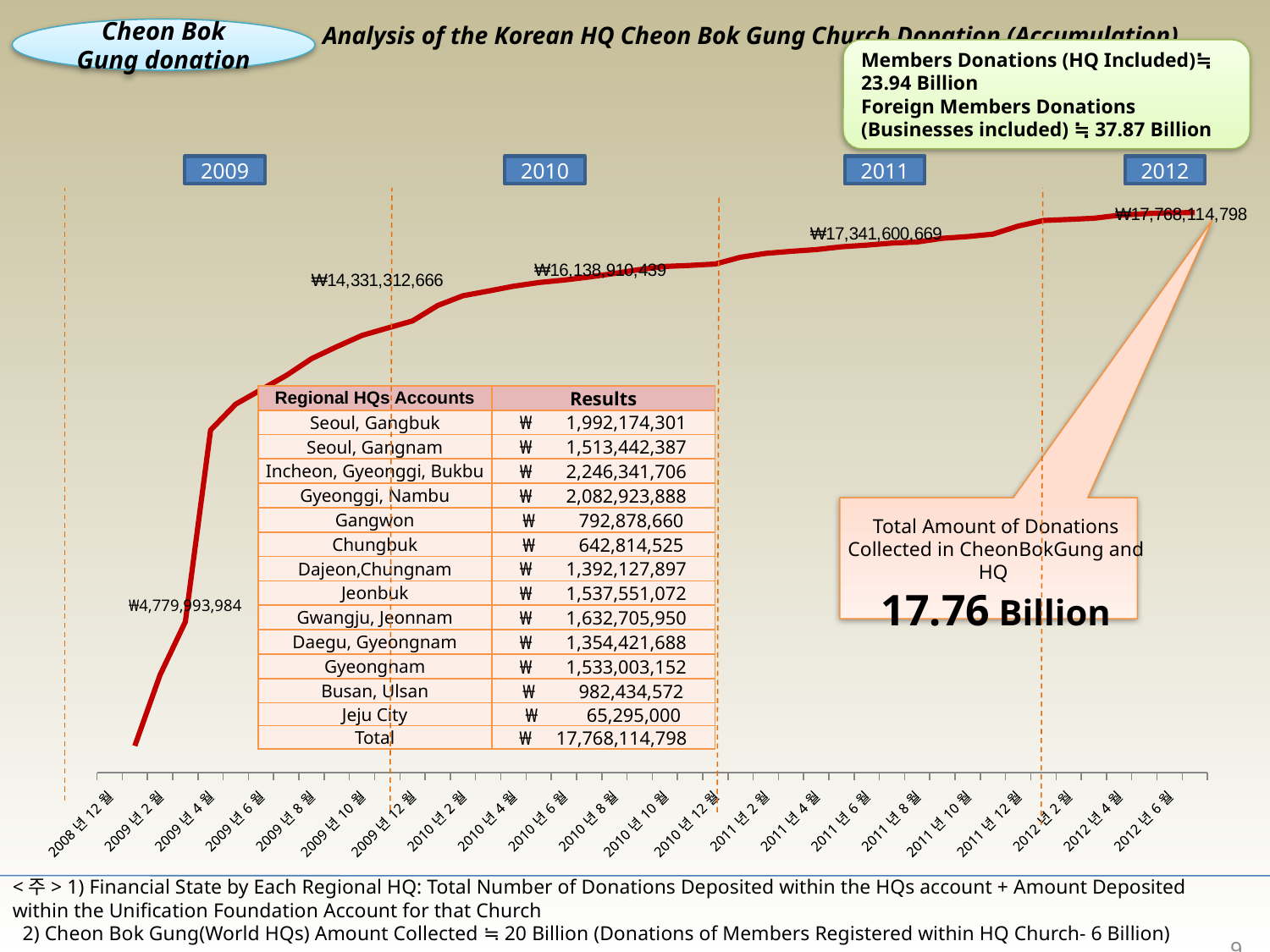
What is the difference between the third data label (₩16,138,910,439) and the second data label (₩14,331,312,666)? ₩1,807,597,773 What is the difference between the last data label (₩17,768,114,798) and the fourth data label (₩17,341,600,669)? ₩426,514,129 What is the second data label value from the left on the line? ₩14,331,312,666 What is the title of the chart? Analysis of the Korean HQ Cheon Bok Gung Church Donation (Accumulation) Does the accumulated donation line rise or fall from left to right along the x axis? rise What is the first (leftmost) data label value shown on the line? ₩4,779,993,984 Which is the highest data label value shown on the line? ₩17,768,114,798 What kind of chart is shown on the slide? line chart What is the fourth data label value from the left on the line? ₩17,341,600,669 How many data labels are printed on the line? 5 What is the third data label value from the left on the line? ₩16,138,910,439 What is the last (rightmost) data label value shown on the line? ₩17,768,114,798